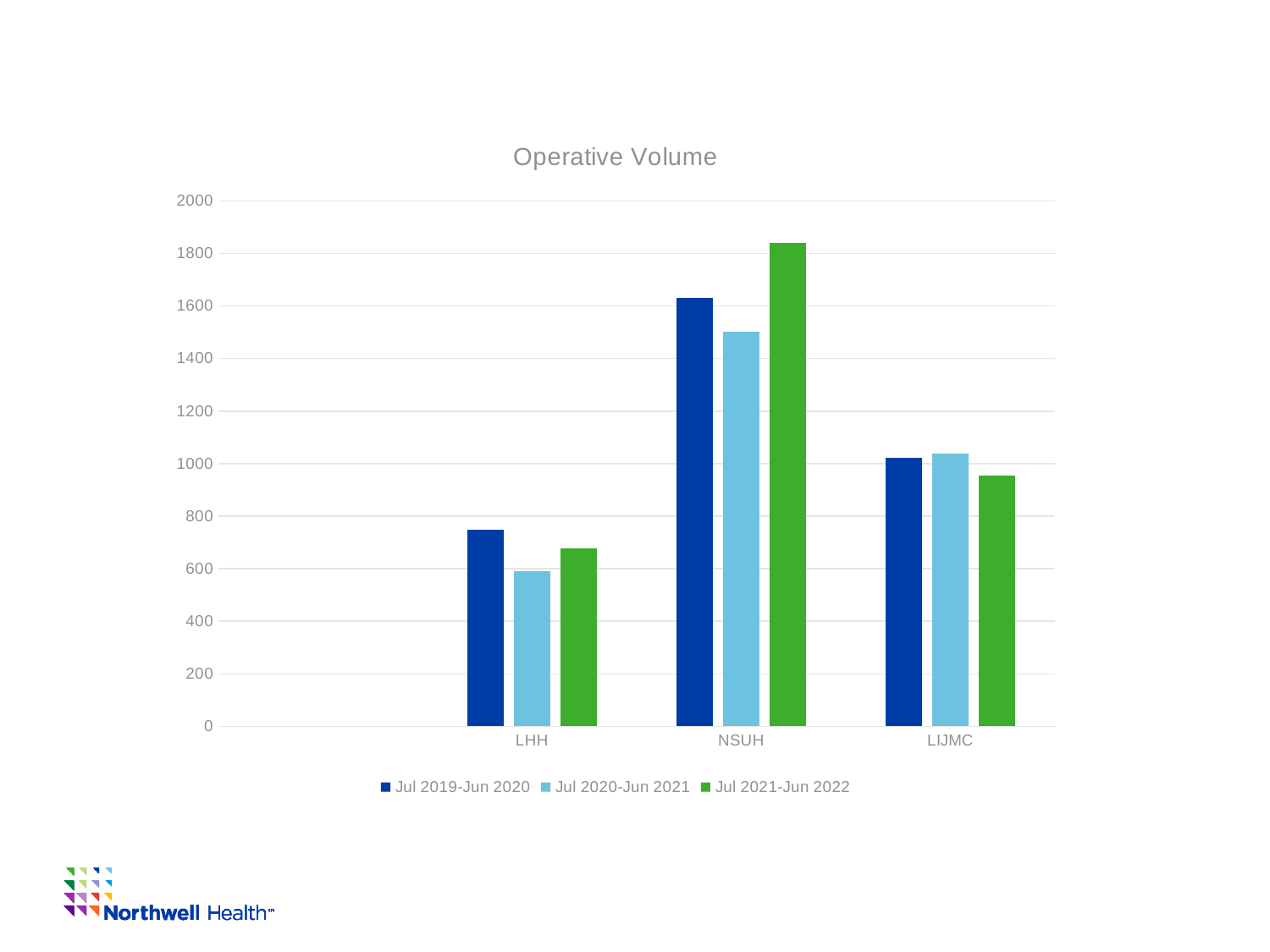
What kind of chart is shown on the slide? bar chart Which hospital has the highest bar in the chart? NSUH Is the value for NSUH in Jul 2021-Jun 2022 greater or less than 1600? greater How many hospital categories are shown on the x axis? 3 Is the value for LHH in Jul 2019-Jun 2020 greater or less than 600? greater What is the title of the chart? Operative Volume Is the value for LHH in Jul 2020-Jun 2021 greater or less than 800? less How many series does the legend list? 3 Which hospital and period has the lowest bar in the chart? LHH, Jul 2020-Jun 2021 For NSUH, which is larger: the Jul 2019-Jun 2020 value or the Jul 2020-Jun 2021 value? Jul 2019-Jun 2020